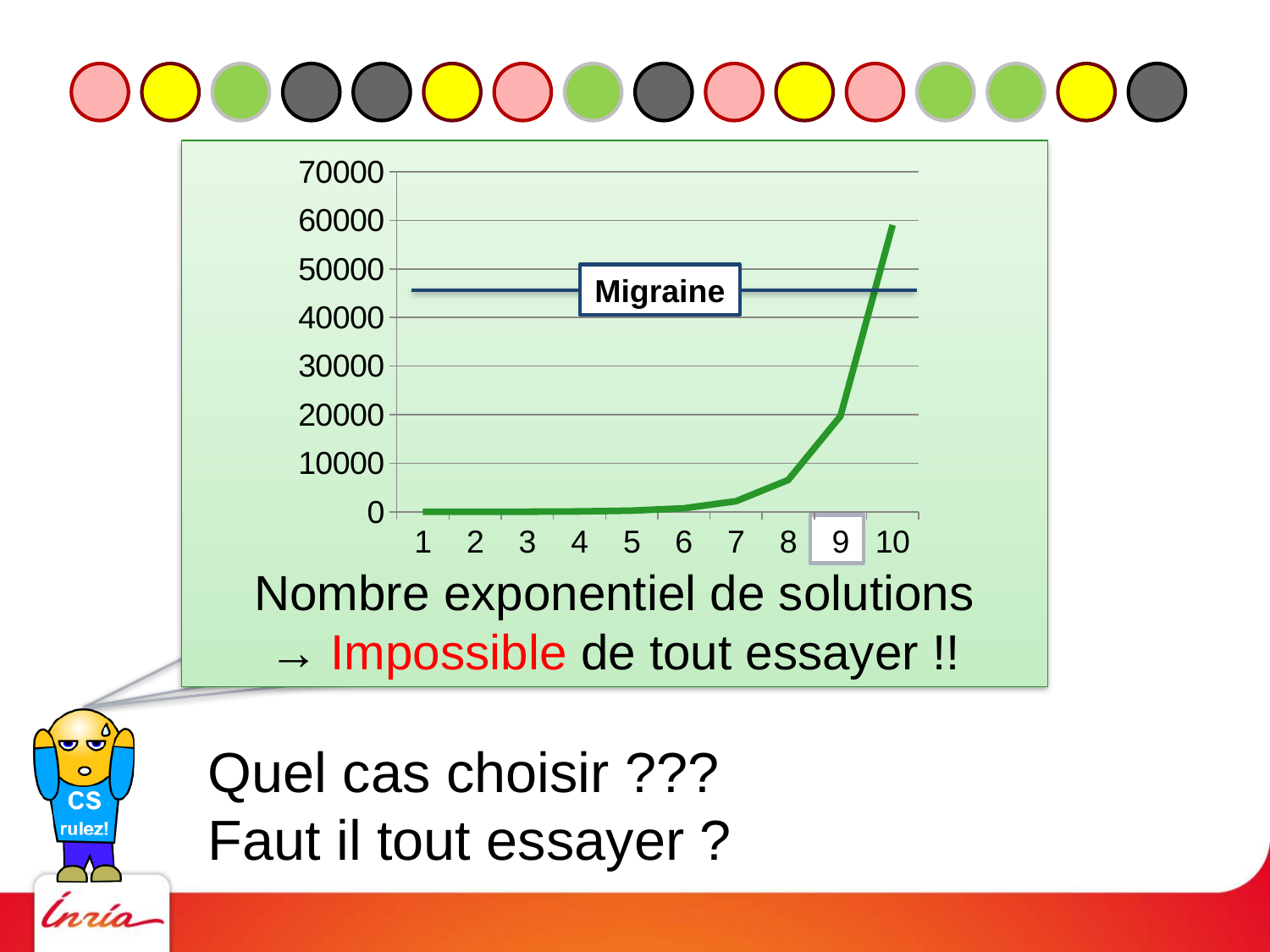
Which is larger: the value of the green line at x = 10 or at x = 9? x = 10 Is the horizontal line labelled Migraine above or below 40000? above How many points are plotted along the x axis of the chart? 10 Do the values of the green line rise or fall as the x axis goes from 1 to 10? rise Is the value of the green line at x = 7 greater or less than 10000? less Is the horizontal line labelled Migraine greater or less than 50000? less What kind of chart is shown on the slide? line chart At which x value does the green line reach its highest point? 10 What is the label shown on the horizontal line in the chart? Migraine